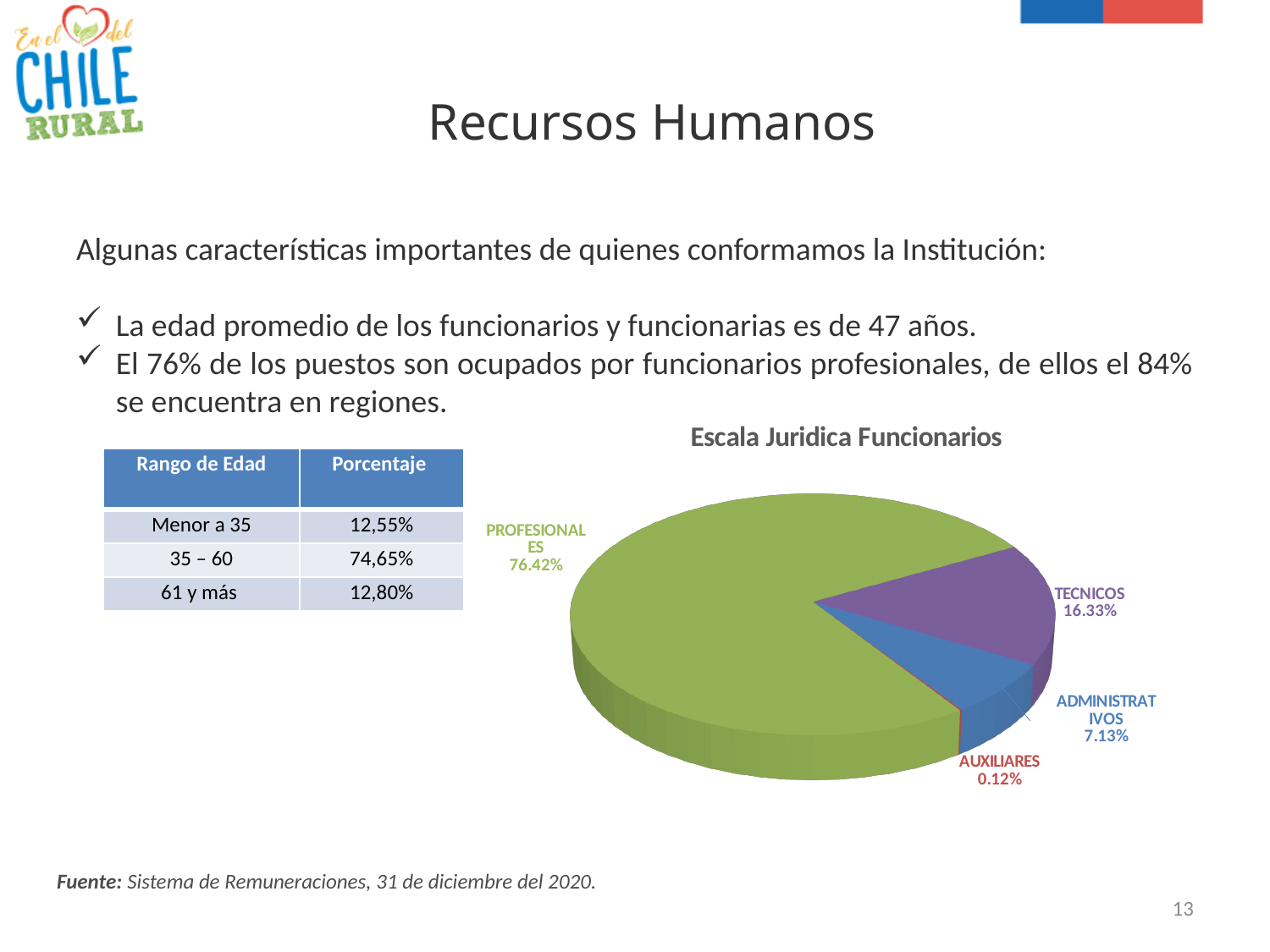
In the "Escala Juridica Funcionarios" chart, what percentage is shown for TECNICOS? 16.33% In the "Escala Juridica Funcionarios" chart, what percentage is shown for PROFESIONALES? 76.42% Which category has the smallest slice in the "Escala Juridica Funcionarios" chart? AUXILIARES What is the title of the pie chart on the slide? Escala Juridica Funcionarios What kind of chart is "Escala Juridica Funcionarios"? Pie chart In the "Escala Juridica Funcionarios" chart, what percentage is shown for ADMINISTRATIVOS? 7.13% In the "Escala Juridica Funcionarios" chart, what is the difference in percentage points between PROFESIONALES and TECNICOS? 60.09 In the "Escala Juridica Funcionarios" chart, what percentage is shown for AUXILIARES? 0.12% In the "Escala Juridica Funcionarios" chart, which is larger: TECNICOS or ADMINISTRATIVOS? TECNICOS Which category has the largest slice in the "Escala Juridica Funcionarios" chart? PROFESIONALES What colour is the PROFESIONALES slice in the "Escala Juridica Funcionarios" chart? Green How many slices does the "Escala Juridica Funcionarios" pie chart have? 4